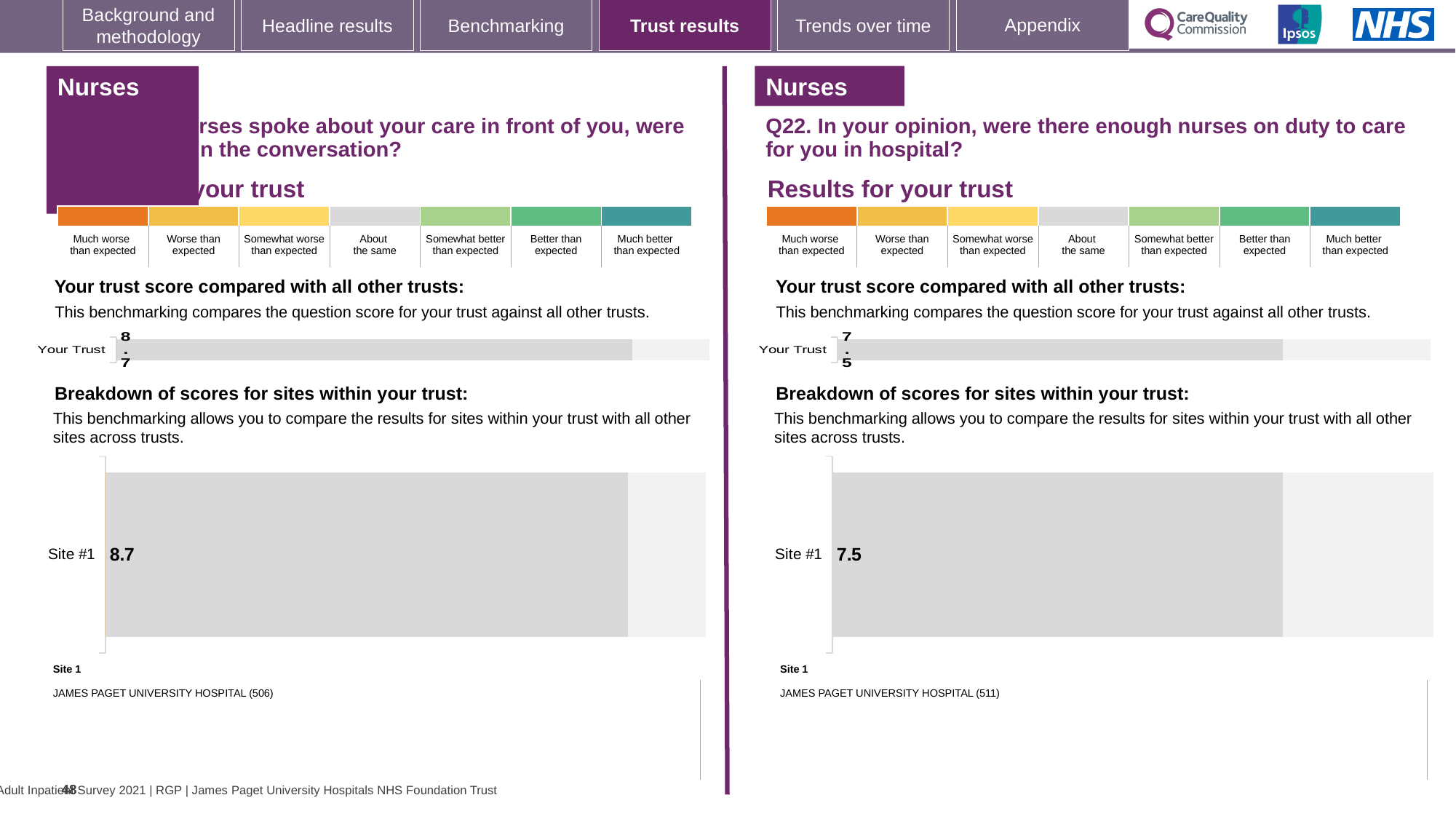
On the right half of the slide (Q22), in the 'Breakdown of scores for sites within your trust' chart, what is the value for Site #1? 7.5 What kind of chart is used to show the Site #1 score on the right half of the slide (Q22)? Bar chart On the left half of the slide, which site is labelled as Site 1 below the breakdown chart? JAMES PAGET UNIVERSITY HOSPITAL (506) On the left half of the slide, in the 'Your trust score compared with all other trusts' chart, what is the value for Your Trust? 8.7 What kind of chart is used to show the Your Trust score on the left half of the slide? Bar chart On the right half of the slide (Q22), in the 'Your trust score compared with all other trusts' chart, what is the value for Your Trust? 7.5 On the right half of the slide (Q22), which site is labelled as Site 1 below the breakdown chart? JAMES PAGET UNIVERSITY HOSPITAL (511) What is the difference between the Site #1 score on the left half of the slide and the Site #1 score on the right half (Q22)? 1.2 How many sites are shown in the 'Breakdown of scores for sites within your trust' chart on the right half of the slide (Q22)? 1 On the left half of the slide, in the 'Breakdown of scores for sites within your trust' chart, what is the value for Site #1? 8.7 How many bars are plotted in the 'Your trust score compared with all other trusts' chart on the left half of the slide? 1 Which is larger: the Your Trust score on the left half of the slide or the Your Trust score on the right half (Q22)? Left half (8.7)